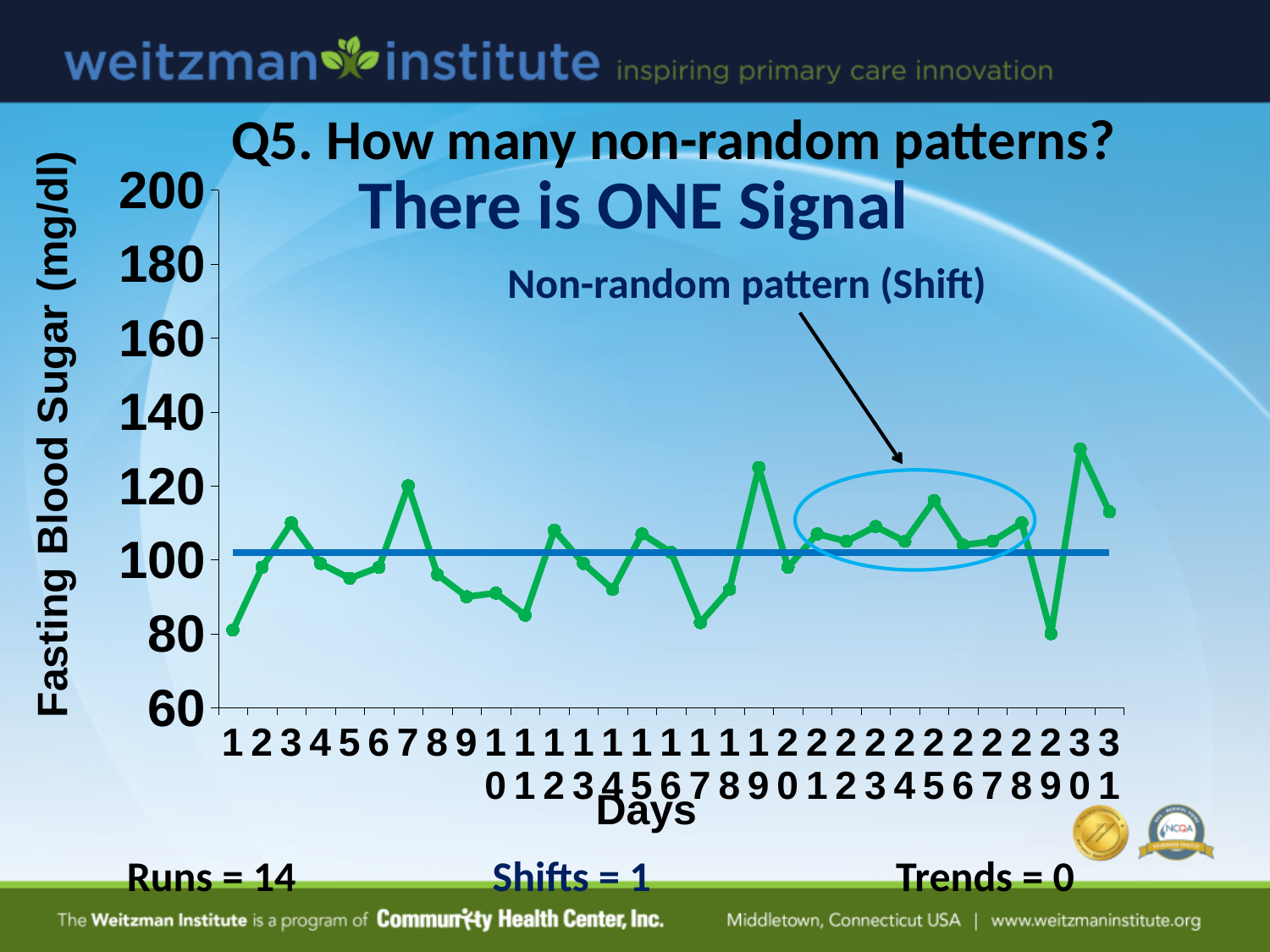
Is the fasting blood sugar value for day 1 greater or less than 100? less Is the fasting blood sugar value for day 30 greater or less than 120? greater Which day has the larger fasting blood sugar value, day 29 or day 30? day 30 According to the text below the chart, how many shifts are there? 1 Is the fasting blood sugar value for day 29 greater or less than 100? less Which day has the larger fasting blood sugar value, day 7 or day 8? day 7 What is the label of the y axis of the chart? Fasting Blood Sugar (mg/dl) What kind of chart is shown on the slide? line chart Which day has the larger fasting blood sugar value, day 19 or day 20? day 19 How many days are plotted along the x axis of the chart? 31